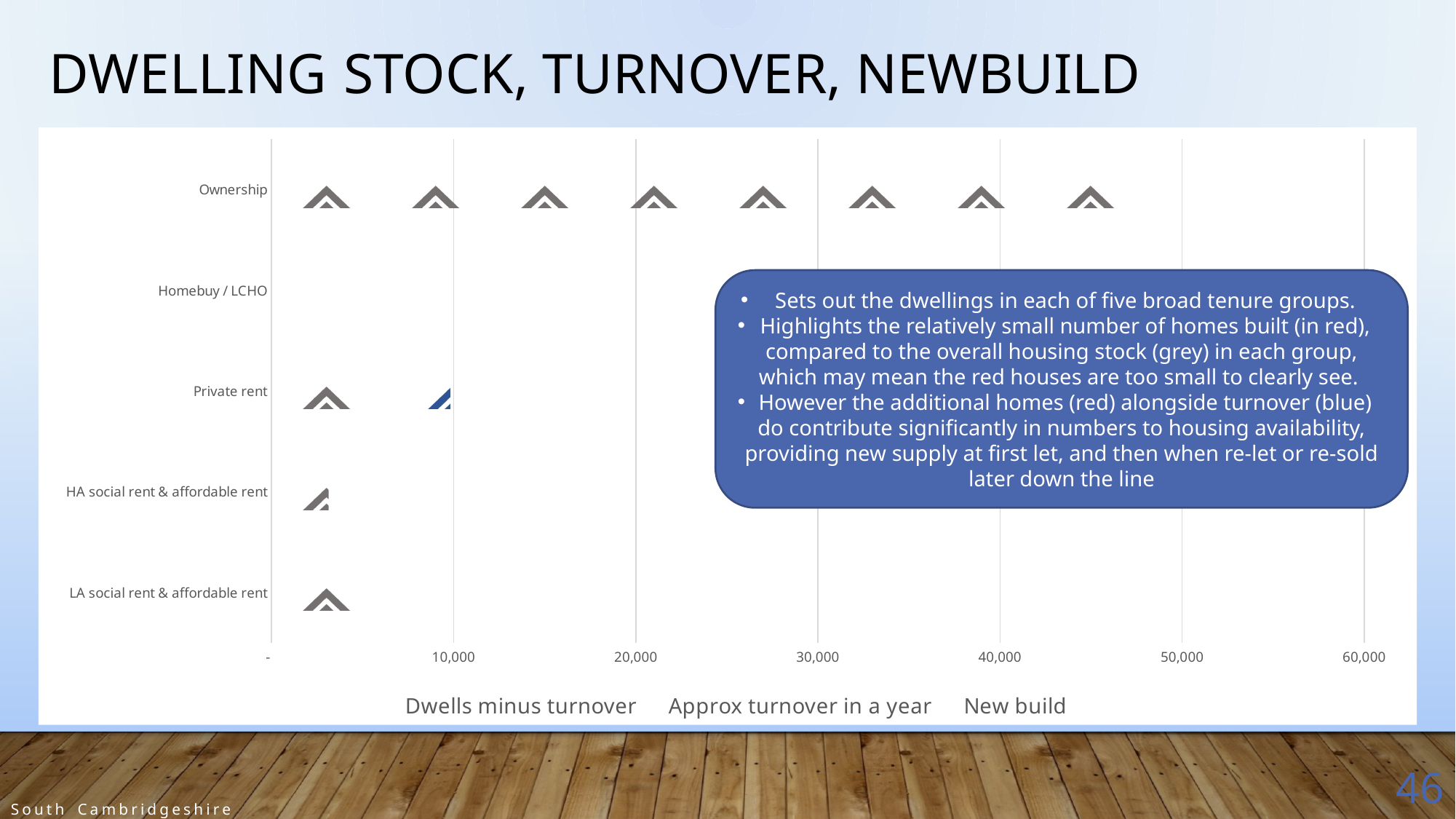
What is the highest tick value shown on the horizontal axis of the chart? 60,000 Which is larger, the total for Ownership or the total for Private rent? Ownership Which tenure category has the largest total dwelling stock in the chart? Ownership How many tenure categories are listed on the vertical axis of the chart? 5 What are the three series named in the chart legend? Dwells minus turnover, Approx turnover in a year, New build Is the total value for LA social rent & affordable rent greater or less than 10,000? less Is the total value for HA social rent & affordable rent greater or less than 10,000? less What kind of chart is shown on the slide? bar chart How many series does the chart legend list? 3 Is the total value for Ownership greater or less than 40,000? greater